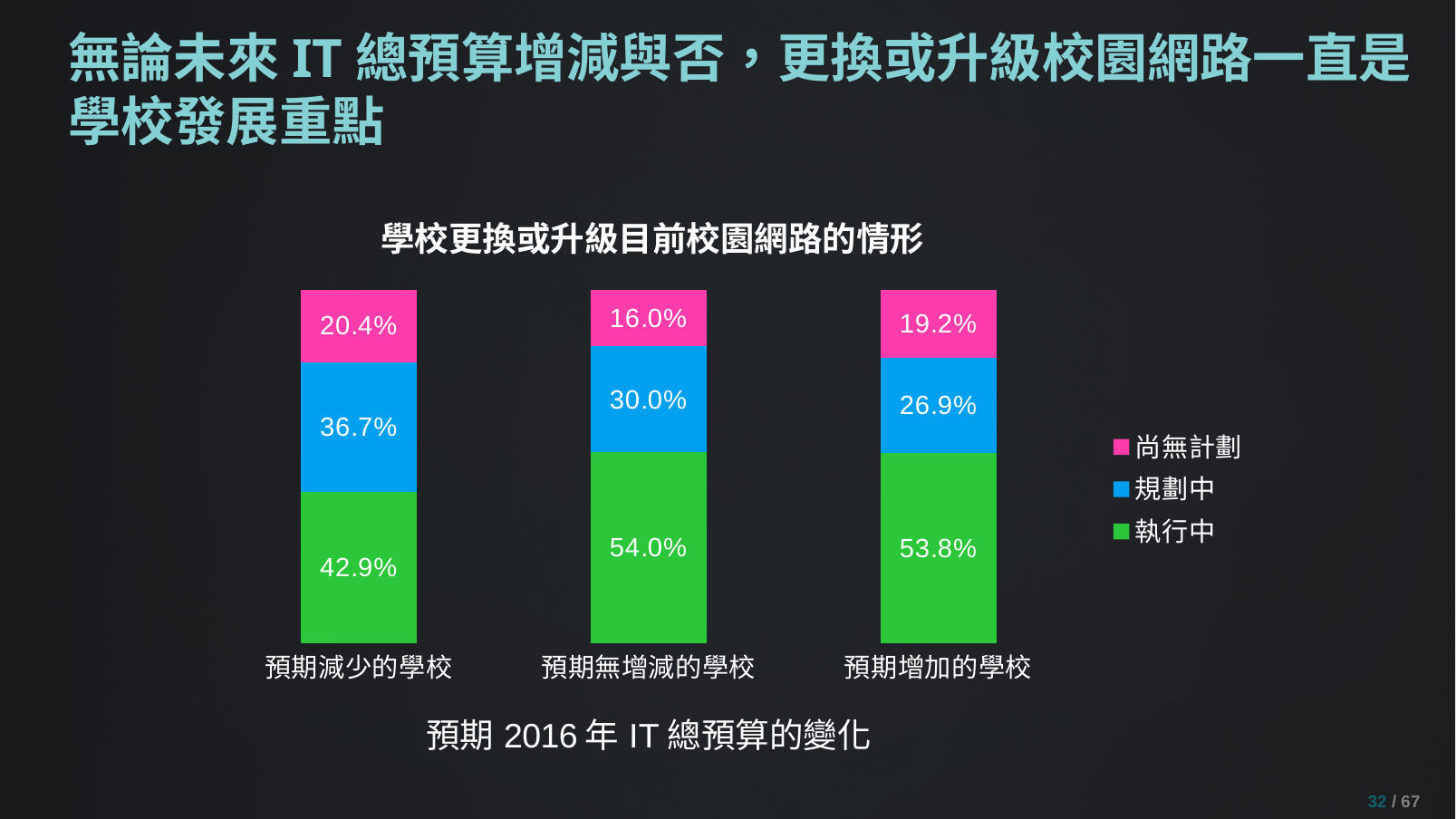
How many categories are shown on the x axis? 3 What is the value for 執行中 in the 預期減少的學校 bar? 42.9% Which is larger: the 規劃中 value for 預期減少的學校 or for 預期增加的學校? 預期減少的學校 Which category has the highest value for 尚無計劃? 預期減少的學校 What kind of chart is shown on the slide? Stacked bar chart What is the total of the stacked bar for 預期減少的學校? 100.0% What is the value for 尚無計劃 in the 預期增加的學校 bar? 19.2% Which category has the lowest value for 規劃中? 預期增加的學校 What is the title of the chart? 學校更換或升級目前校園網路的情形 What is the difference between the 執行中 values for 預期無增減的學校 and 預期減少的學校? 11.1 percentage points How many series does the legend list? 3 What is the value for 規劃中 in the 預期無增減的學校 bar? 30.0%